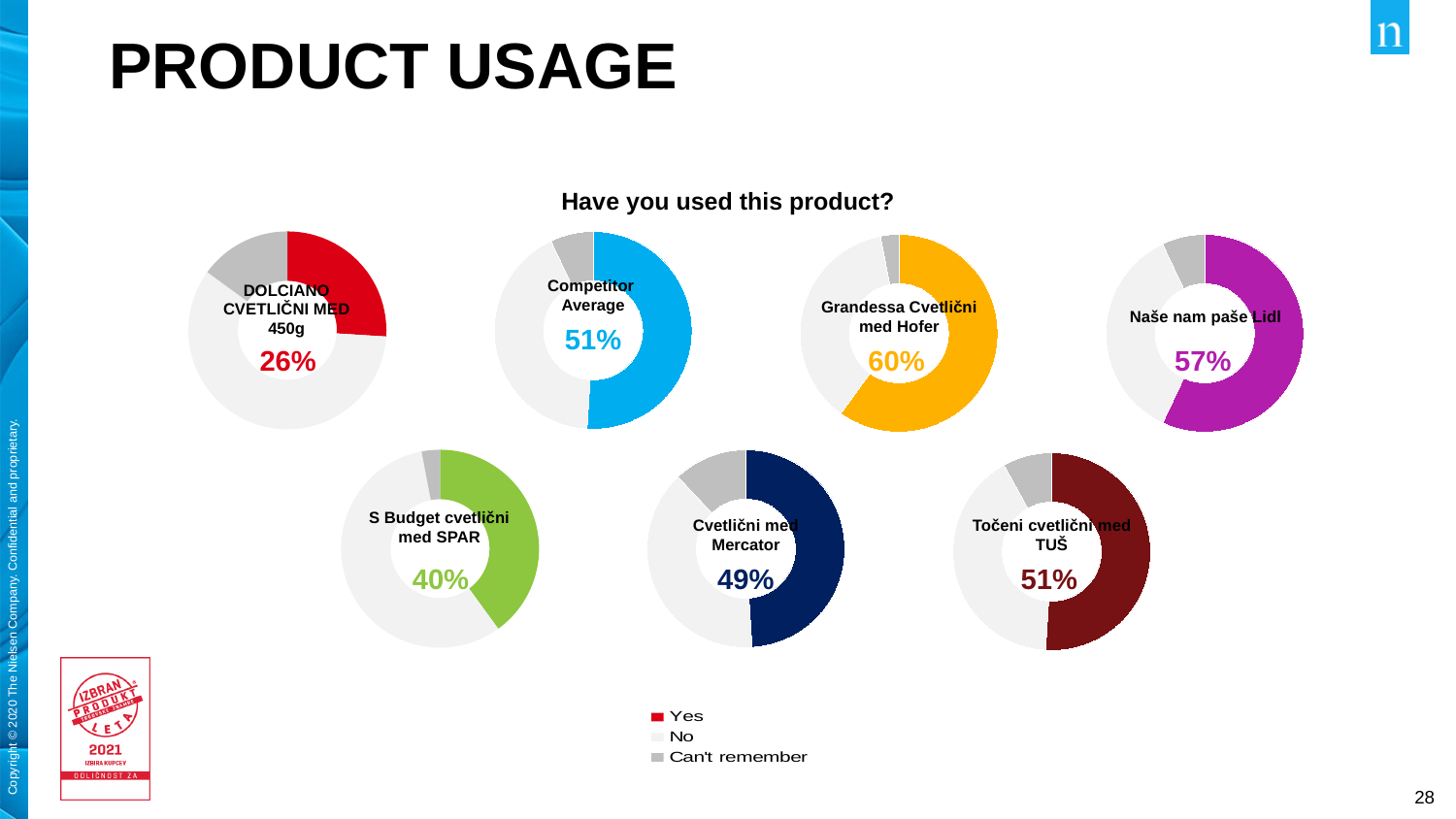
What is the difference between the 'Yes' percentage for Grandessa Cvetlični med Hofer and the 'Yes' percentage for DOLCIANO CVETLIČNI MED 450g? 34% How many donut charts are shown on the slide? 7 In the S Budget cvetlični med SPAR donut chart, what is the 'Yes' percentage shown? 40% Which has a higher 'Yes' percentage: Naše nam paše Lidl or Točeni cvetlični med TUŠ? Naše nam paše Lidl In the Grandessa Cvetlični med Hofer donut chart, what is the 'Yes' percentage shown? 60% Across all the donut charts on the slide, which product has the highest 'Yes' percentage? Grandessa Cvetlični med Hofer What question is posed as the heading above the charts? Have you used this product? In the Cvetlični med Mercator donut chart, what percentage is printed in the centre? 49% How many entries does the legend at the bottom of the slide list? 3 Across all the donut charts on the slide, which product has the lowest 'Yes' percentage? DOLCIANO CVETLIČNI MED 450g In the Naše nam paše Lidl donut chart, what percentage is printed in the centre? 57% In the DOLCIANO CVETLIČNI MED 450g donut chart, what percentage of respondents said they have used the product? 26%